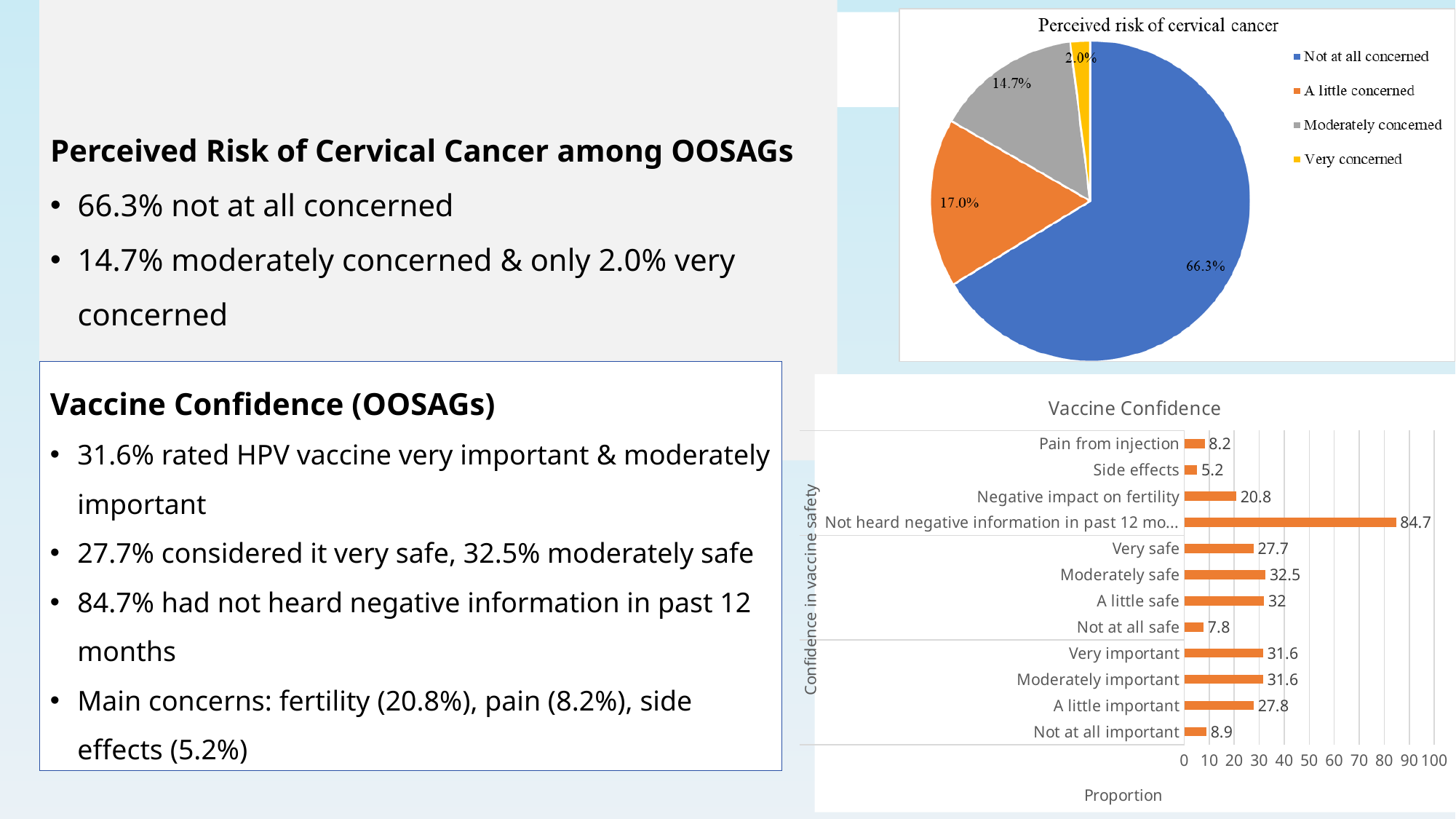
In the 'Perceived risk of cervical cancer' pie chart, what is the difference between the 'A little concerned' and 'Moderately concerned' shares? 2.3% In the 'Vaccine Confidence' chart, which is larger: 'A little important' or 'Very important'? Very important What type of chart is the 'Perceived risk of cervical cancer' chart? Pie chart In the 'Vaccine Confidence' chart, which category has the highest value? Not heard negative information in past 12 mo... What is the x-axis title of the 'Vaccine Confidence' chart? Proportion How many categories does the legend of the 'Perceived risk of cervical cancer' pie chart list? 4 In the 'Perceived risk of cervical cancer' pie chart, which category has the smallest slice? Very concerned How many categories are plotted in the 'Vaccine Confidence' bar chart? 12 In the 'Vaccine Confidence' chart, which category has the lowest value? Side effects In the 'Vaccine Confidence' chart, what is the difference between 'Moderately safe' and 'Very safe'? 4.8 In the 'Vaccine Confidence' chart, what is the value for 'Negative impact on fertility'? 20.8 In the 'Perceived risk of cervical cancer' pie chart, what share is labelled for 'Not at all concerned'? 66.3%